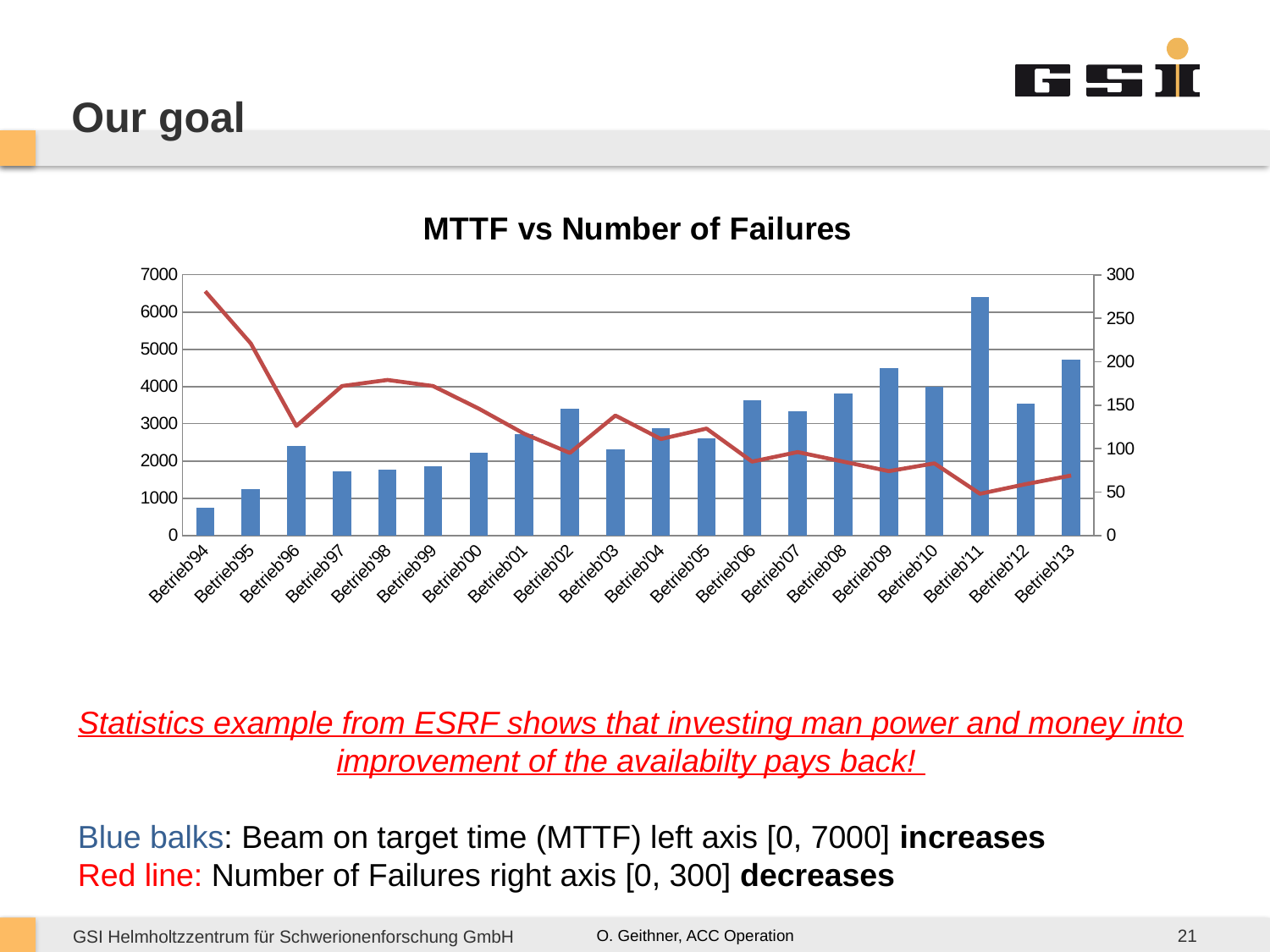
Does the red line generally rise or fall from Betrieb'94 to Betrieb'13? fall Is the red line value for Betrieb'13 greater or less than 100 on the right axis? less Which has the taller blue bar, Betrieb'12 or Betrieb'13? Betrieb'13 Is the blue bar for Betrieb'94 greater or less than 1000 on the left axis? less Which category has the tallest blue bar? Betrieb'11 What is the title of the chart? MTTF vs Number of Failures Is the red line value for Betrieb'94 greater or less than 250 on the right axis? greater What kind of chart is shown on the slide? A bar chart combined with a line Which category has the shortest blue bar? Betrieb'94 How many categories (Betrieb years) are shown on the x axis? 20